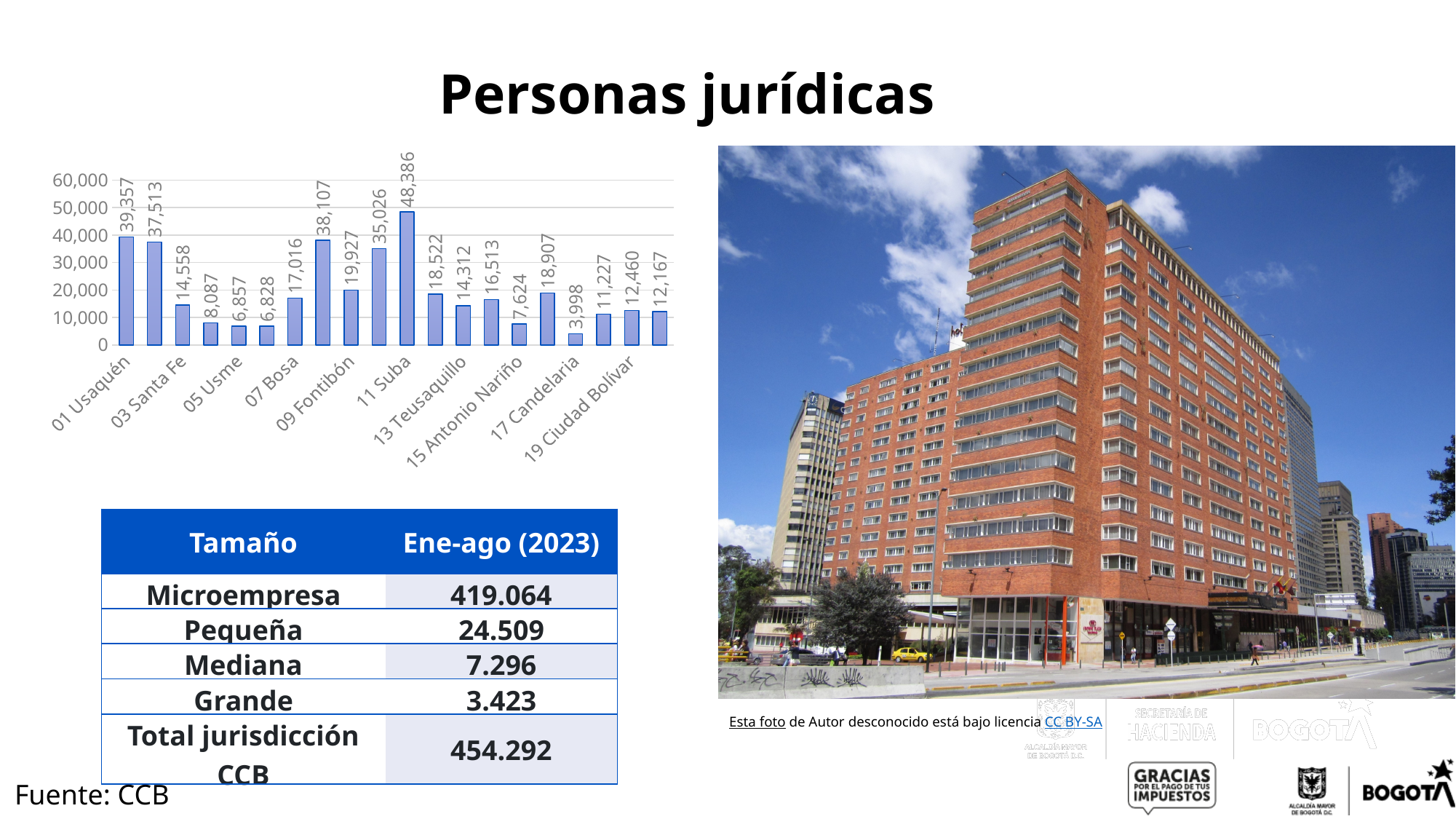
Which is larger, the value for 07 Bosa or 09 Fontibón? 09 Fontibón How many bars are plotted in the chart? 20 Which labeled category has the highest value? 11 Suba Which labeled category has the lowest value? 17 Candelaria What is the value for 11 Suba? 48,386 Is the value for 05 Usme greater or less than 10,000? less What is the value for 19 Ciudad Bolívar? 12,460 What is the value for 01 Usaquén? 39,357 What is the highest value shown on the vertical axis? 60,000 What type of chart is shown on the slide? bar chart What is the difference between the values for 01 Usaquén and 03 Santa Fe? 24,799 What is the value for 17 Candelaria? 3,998